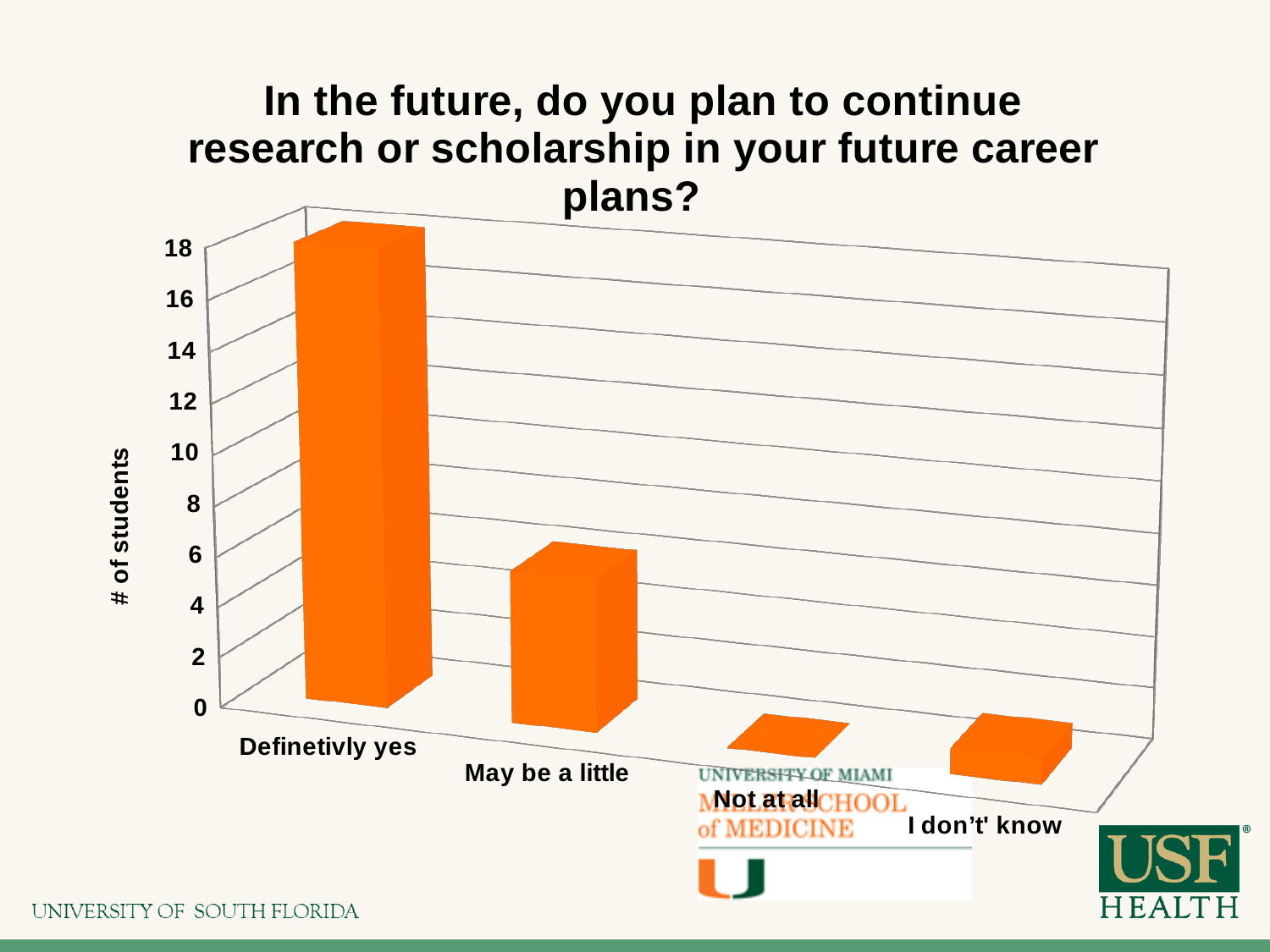
What is the title of the chart? In the future, do you plan to continue research or scholarship in your future career plans? What kind of chart is shown on the slide? bar chart Do the bar values generally rise or fall moving from left to right along the x axis? fall Is the value for "I don't' know" greater or less than 4? less Which has more students, "Definetivly yes" or "May be a little"? Definetivly yes Is the value for "Definetivly yes" greater or less than 16? greater How many categories are shown on the x axis of the chart? 4 Is the value for "May be a little" greater or less than 8? less What is the label of the vertical axis? # of students Which category has the highest number of students? Definetivly yes